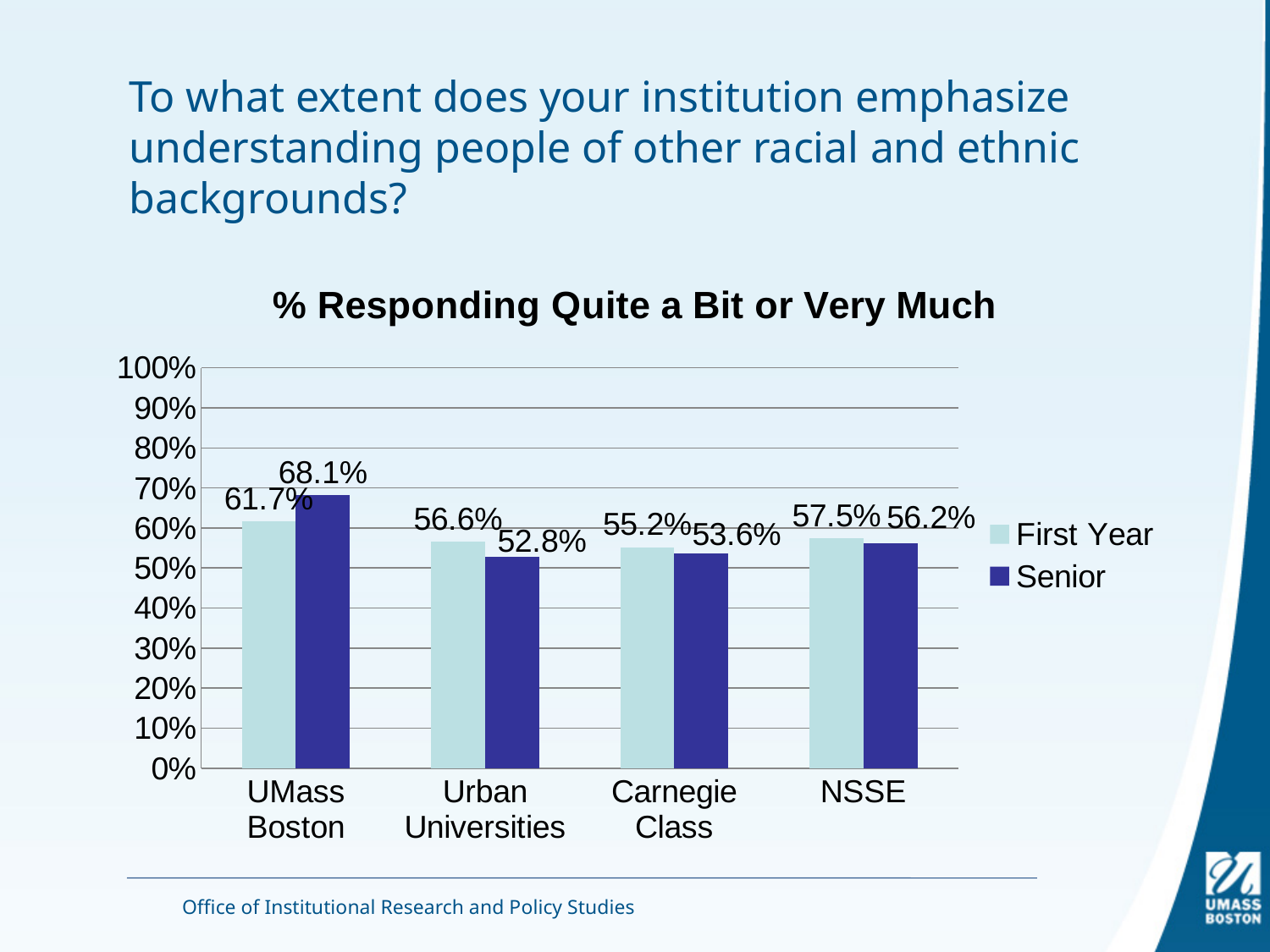
What is the Senior value for NSSE? 56.2% How many categories are shown on the x axis? 4 Which category has the lowest First Year value? Carnegie Class What kind of chart is shown? bar chart What is the Senior value for Urban Universities? 52.8% What is the First Year value for UMass Boston? 61.7% Which is larger for Urban Universities, the First Year value or the Senior value? First Year Which category has the highest Senior value? UMass Boston What is the difference between the Senior and First Year values for UMass Boston? 6.4% What is the title of the chart? % Responding Quite a Bit or Very Much Is the Senior value for Carnegie Class greater or less than 60%? less How many series does the legend list? 2